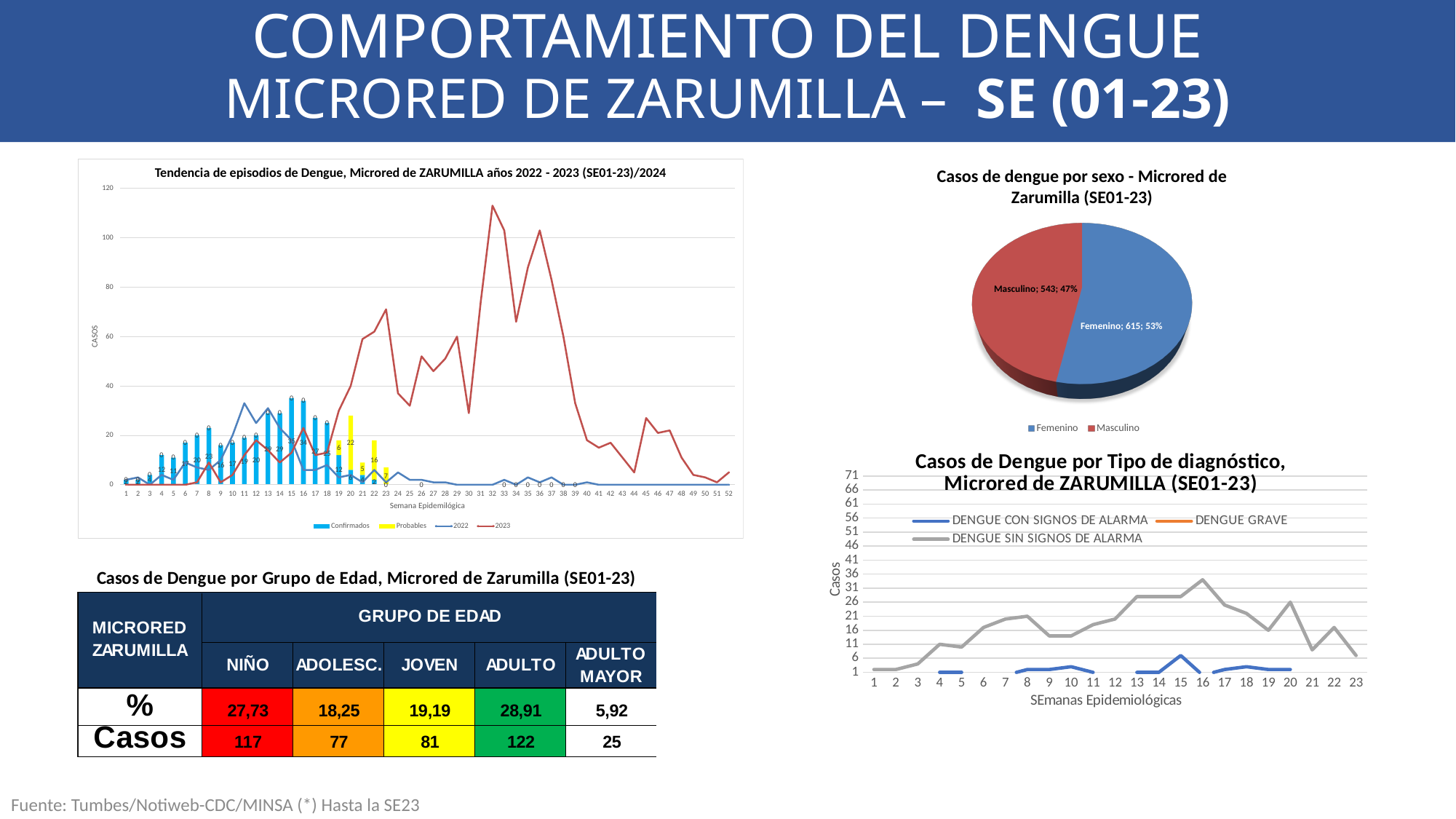
How many series does the legend of the chart 'Casos de Dengue por Tipo de diagnóstico' list? 3 In the pie chart 'Casos de dengue por sexo', what share of cases is Masculino? 47% In the pie chart 'Casos de dengue por sexo', what is the difference between the Femenino and Masculino case counts? 72 How many entries does the legend of the pie chart 'Casos de dengue por sexo' list? 2 In the chart 'Casos de Dengue por Tipo de diagnóstico', how many epidemiological weeks are shown on the x axis? 23 In the chart 'Tendencia de episodios de Dengue', is the peak value of the 2023 line greater or less than 100? greater In the pie chart 'Casos de dengue por sexo', what is the total number of cases across both slices? 1158 In the pie chart 'Casos de dengue por sexo', which sex has the larger number of cases? Femenino In the chart 'Casos de Dengue por Tipo de diagnóstico', is the value for DENGUE SIN SIGNOS DE ALARMA at week 16 greater or less than 26? greater In the chart 'Casos de Dengue por Tipo de diagnóstico', at which week does DENGUE SIN SIGNOS DE ALARMA reach its highest value? 16 In the pie chart 'Casos de dengue por sexo', how many cases are Femenino? 615 What kind of chart is 'Casos de Dengue por Tipo de diagnóstico'? Line chart